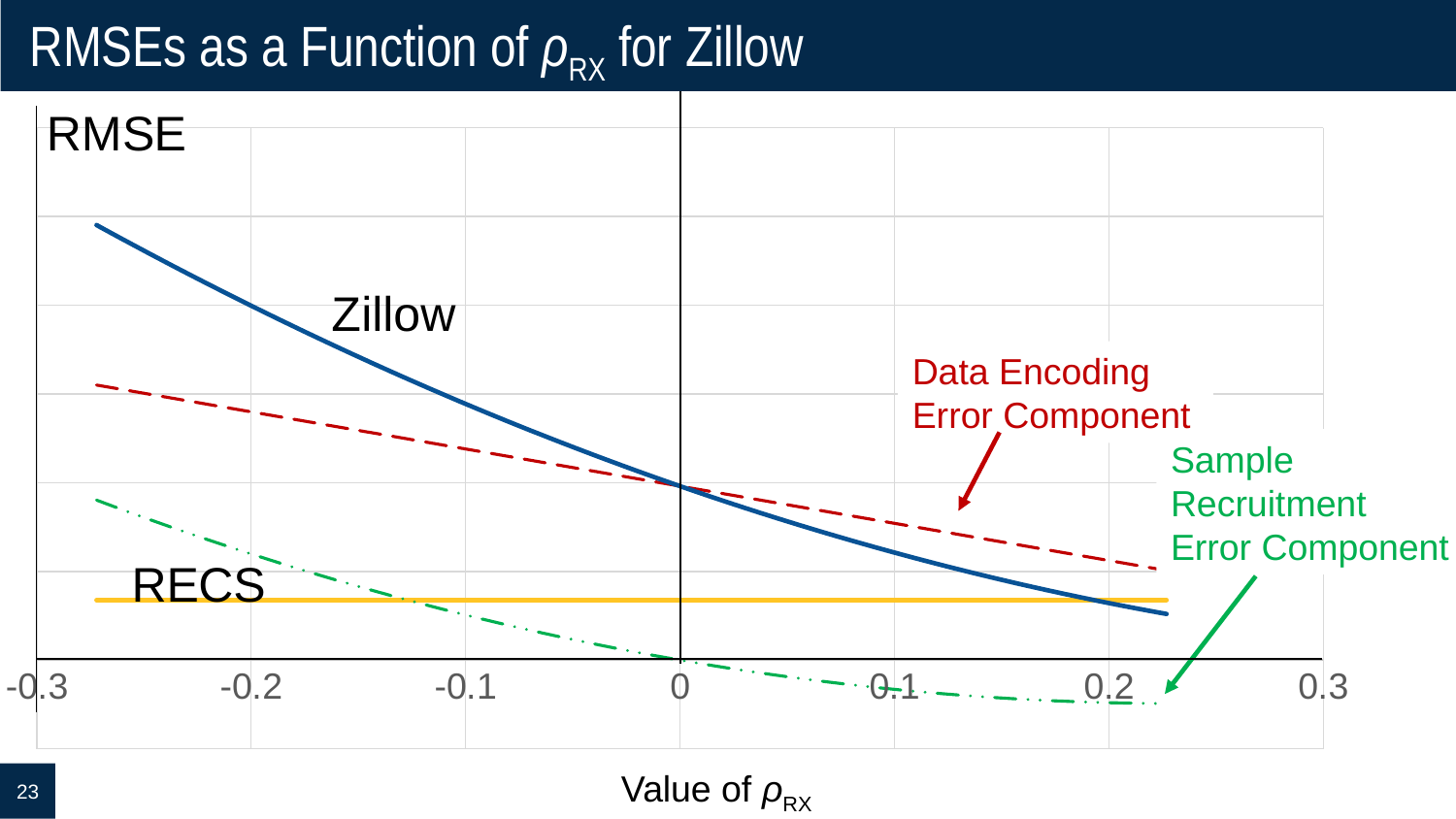
Does the Data Encoding Error Component line rise or fall as ρRX increases? Falls At ρRX = 0.1, which is higher: the Data Encoding Error Component line or the Zillow line? Data Encoding Error Component Does the Zillow line rise or fall as the value of ρRX increases? Falls What kind of chart is shown on the slide? Line chart What is the label of the x axis? Value of ρRX What is the title of the chart on the slide? RMSEs as a Function of ρRX for Zillow How many lines are plotted on the chart? 4 At ρRX = -0.2, which is higher: the Zillow line or the RECS line? Zillow Does the RECS line rise, fall, or stay flat as ρRX increases? Stays flat How many tick labels are shown on the x axis? 7 At ρRX = -0.2, which is higher: the Zillow line or the Data Encoding Error Component line? Zillow Which line is the lowest on the chart at ρRX = 0.1? Sample Recruitment Error Component